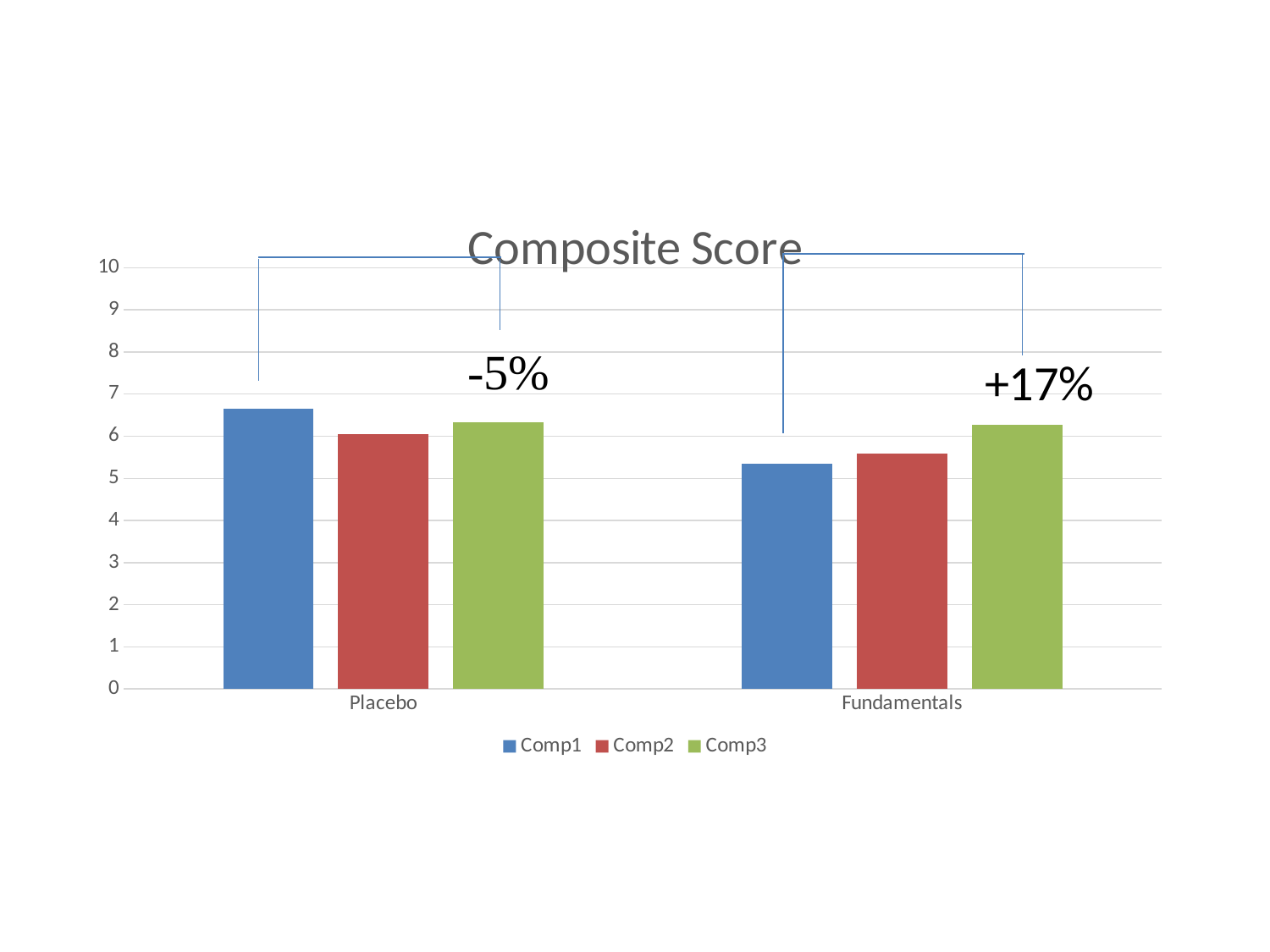
How many series does the legend list? 3 What type of chart is shown on the slide? bar chart Is the value for Comp1 in the Fundamentals group greater or less than 6? less Is the value for Comp3 in the Placebo group greater or less than 6? greater Is the value for Comp2 in the Fundamentals group greater or less than 6? less Which series has the highest value in the Fundamentals group? Comp3 What is the title of the chart? Composite Score Which is larger, the Comp1 value for Placebo or the Comp1 value for Fundamentals? Placebo What percentage change is annotated above the Fundamentals group? +17% How many categories are shown on the x axis? 2 Which series has the highest value in the Placebo group? Comp1